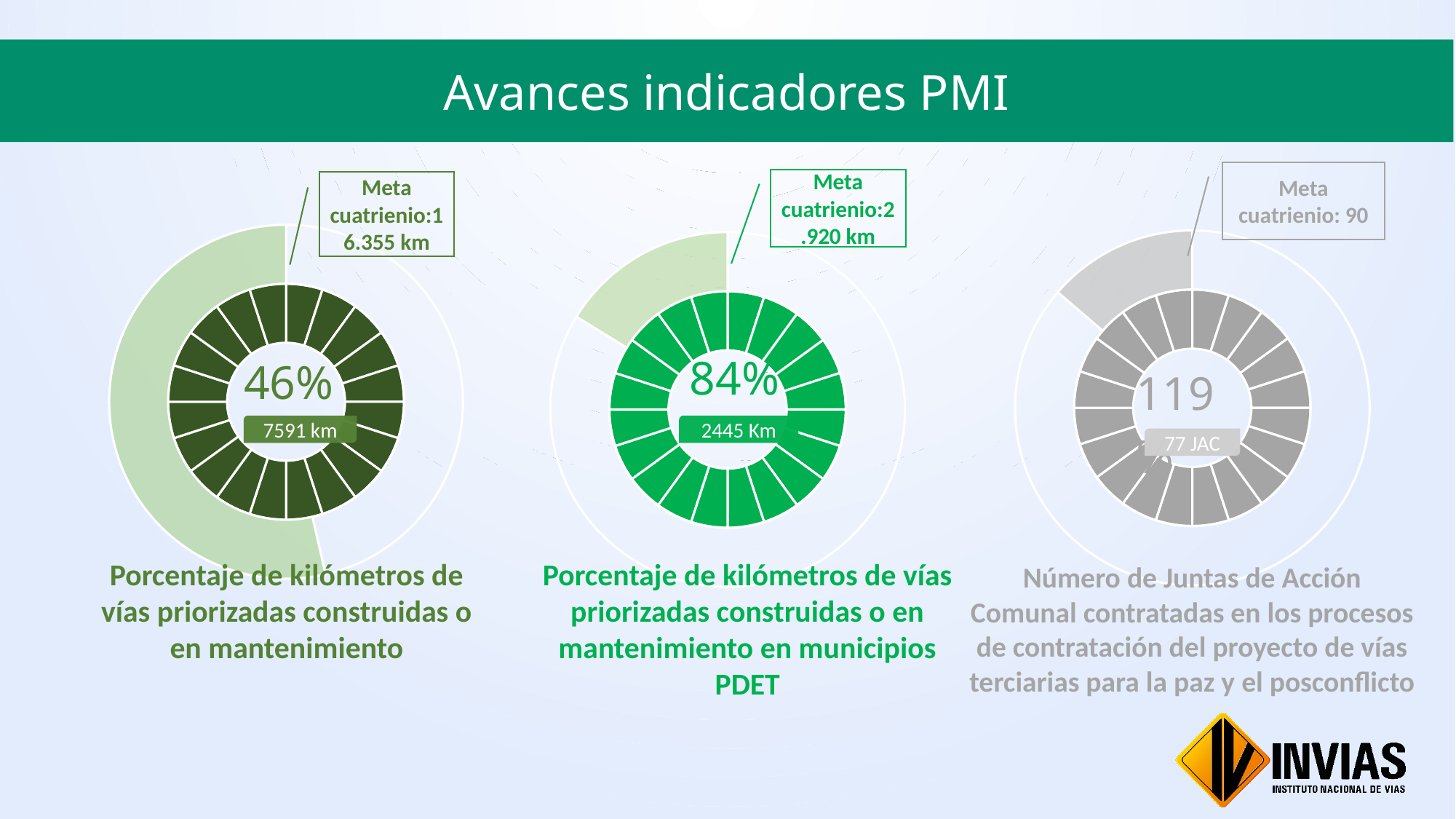
What is the difference in percentage points between the middle chart's 84% and the left chart's 46%? 38 percentage points What is the 'Meta cuatrienio' value shown for the left chart? 16.355 km Which chart shows the higher percentage: the left chart (vías priorizadas) or the middle chart (municipios PDET)? The middle chart (municipios PDET), 84% What percentage is shown in the centre of the middle chart, 'Porcentaje de kilómetros de vías priorizadas construidas o en mantenimiento en municipios PDET'? 84% What is the 'Meta cuatrienio' value shown for the middle chart (municipios PDET)? 2.920 km How many kilometres are labelled inside the left chart (46%)? 7591 km What is the 'Meta cuatrienio' value shown for the right chart (Juntas de Acción Comunal)? 90 How many charts are shown on the slide? 3 What kind of chart is used for each of the three indicators on the slide? Donut (ring) chart How many kilometres are labelled inside the middle chart (84%)? 2445 Km What percentage is shown in the centre of the left chart, 'Porcentaje de kilómetros de vías priorizadas construidas o en mantenimiento'? 46% What number is shown in the centre of the right chart, 'Número de Juntas de Acción Comunal contratadas'? 119